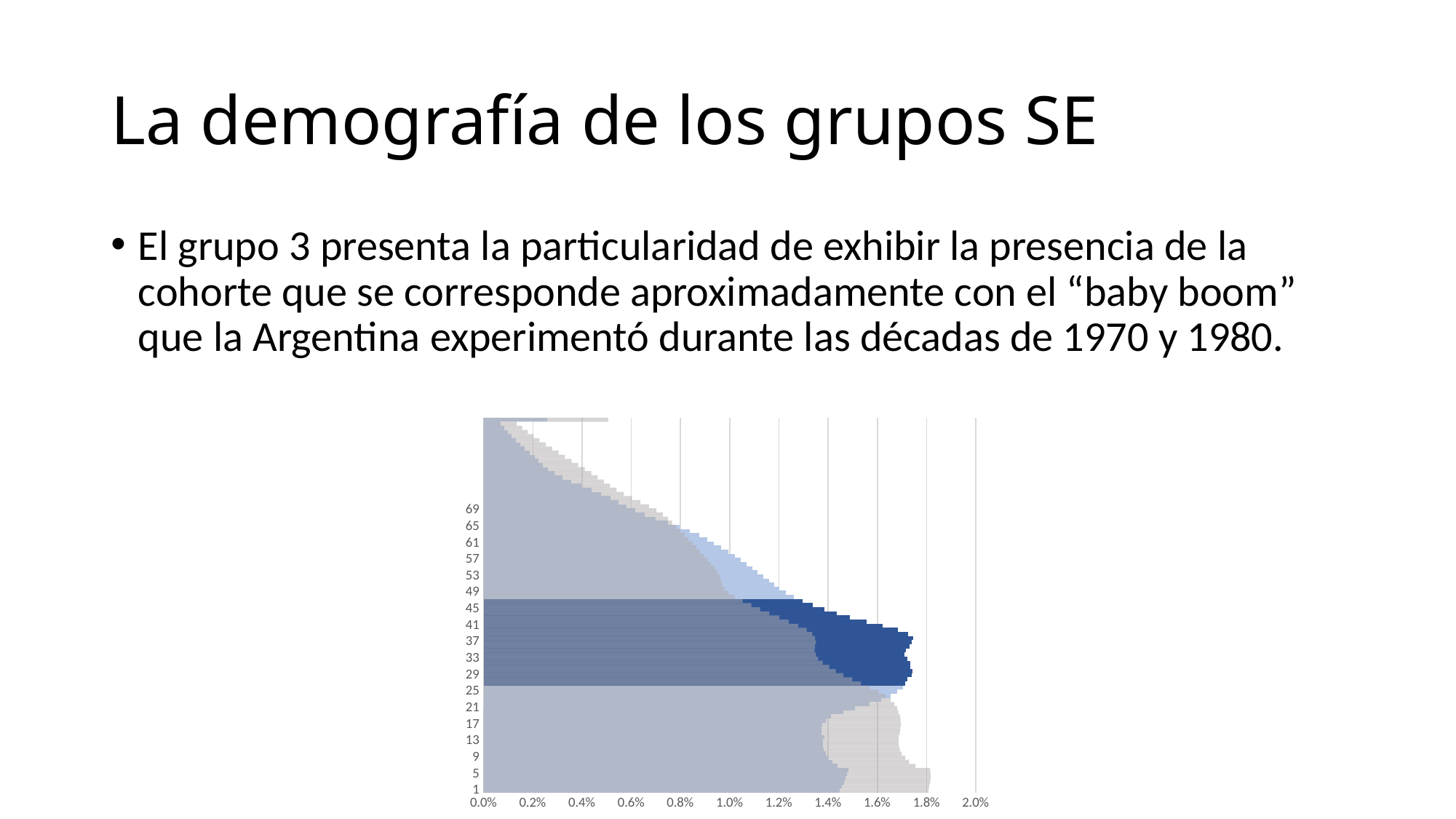
Do the dark blue bars get longer or shorter as age increases from 29 to 45? shorter Is the dark blue bar for age 29 greater or less than 1.4%? greater Is the grey bar for age 1 greater or less than 1.6%? greater What is the lowest value labelled on the horizontal axis of the chart? 0.0% What kind of chart is shown on the slide? bar chart Do the grey bars get longer or shorter as age increases from 49 to 69? shorter Is the light blue bar for age 61 greater or less than 1.0%? less Which is longer: the dark blue bar at age 33 or the light blue bar at age 61? the dark blue bar at age 33 What is the highest value labelled on the horizontal axis of the chart? 2.0%